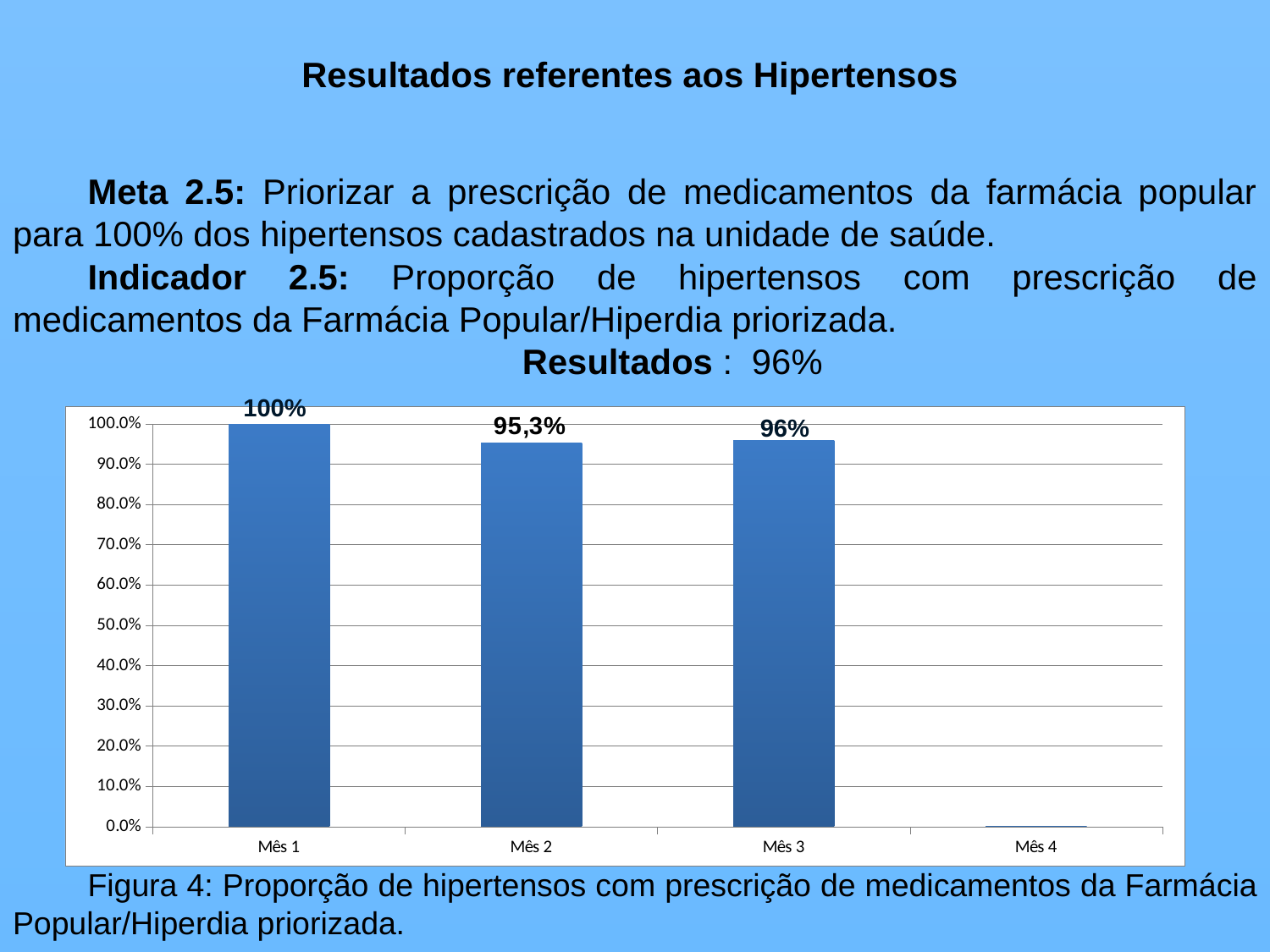
What is the value for Mês 2? 95,3% What is the value for Mês 3? 96% How many month categories are shown on the x axis? 4 What is the highest tick value shown on the y axis? 100.0% What is the value for Mês 1? 100% Which month has the highest value? Mês 1 What is the difference between the values for Mês 1 and Mês 3? 4% What kind of chart is shown on the slide? bar chart Which of Mês 2 and Mês 3 has the larger value? Mês 3 Does the value rise or fall from Mês 1 to Mês 2? fall Is the value for Mês 2 greater or less than 90.0%? greater What is the difference between the values for Mês 1 and Mês 2? 4,7%